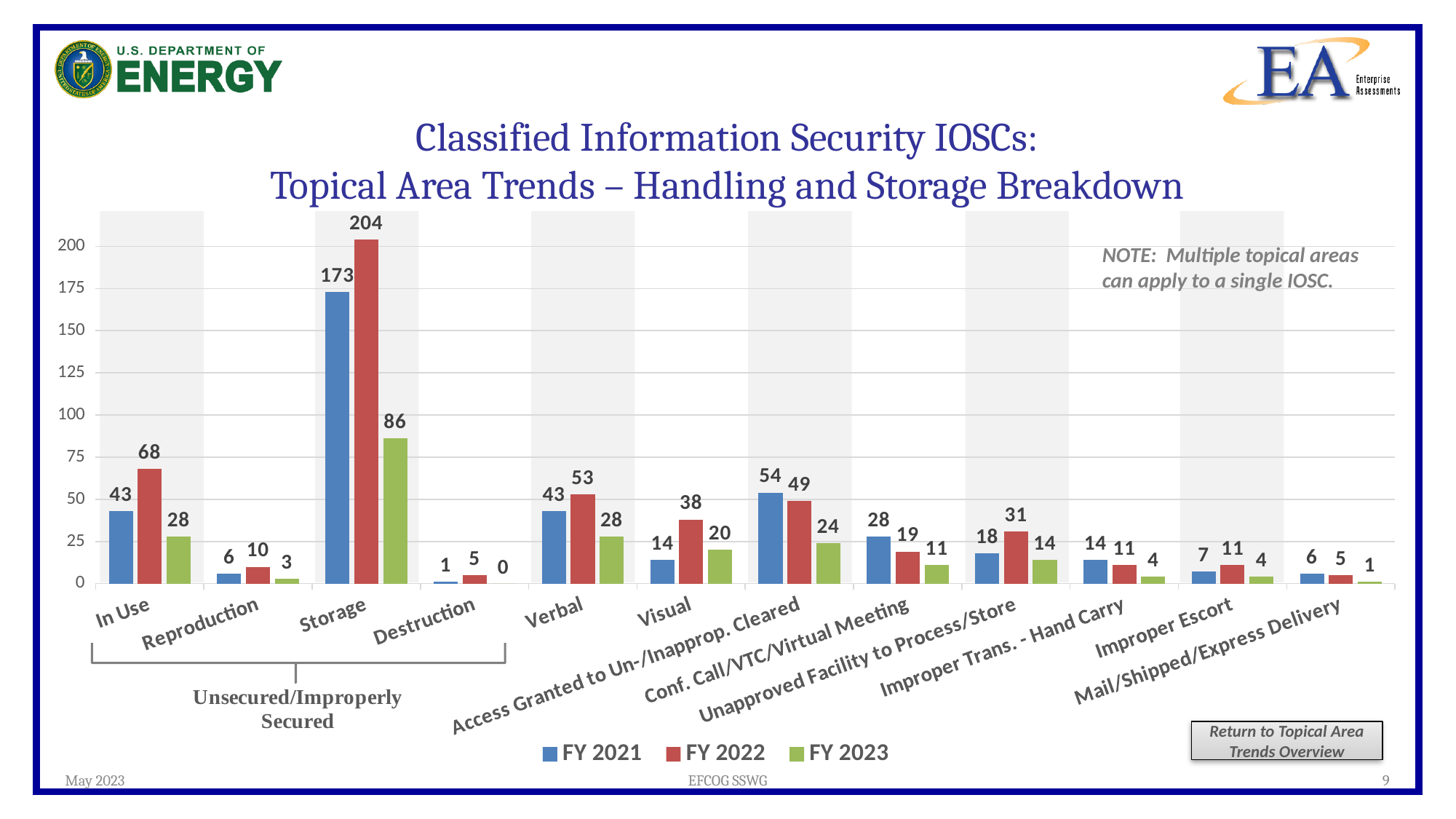
How many series does the legend list? 3 What is the FY 2021 value for Access Granted to Un-/Inapprop. Cleared? 54 Which category has the lowest FY 2023 value? Destruction Is the FY 2021 value for Storage greater or less than 150? greater Which is larger for Conf. Call/VTC/Virtual Meeting: the FY 2021 value or the FY 2022 value? FY 2021 What kind of chart is shown on the slide? bar chart Which four categories are grouped under the bracket labelled Unsecured/Improperly Secured? In Use, Reproduction, Storage, Destruction How many categories are shown on the x axis? 12 What is the difference between the FY 2022 and FY 2023 values for Storage? 118 Which category has the highest FY 2021 value? Storage What is the FY 2022 value for Storage? 204 What is the FY 2023 value for Visual? 20